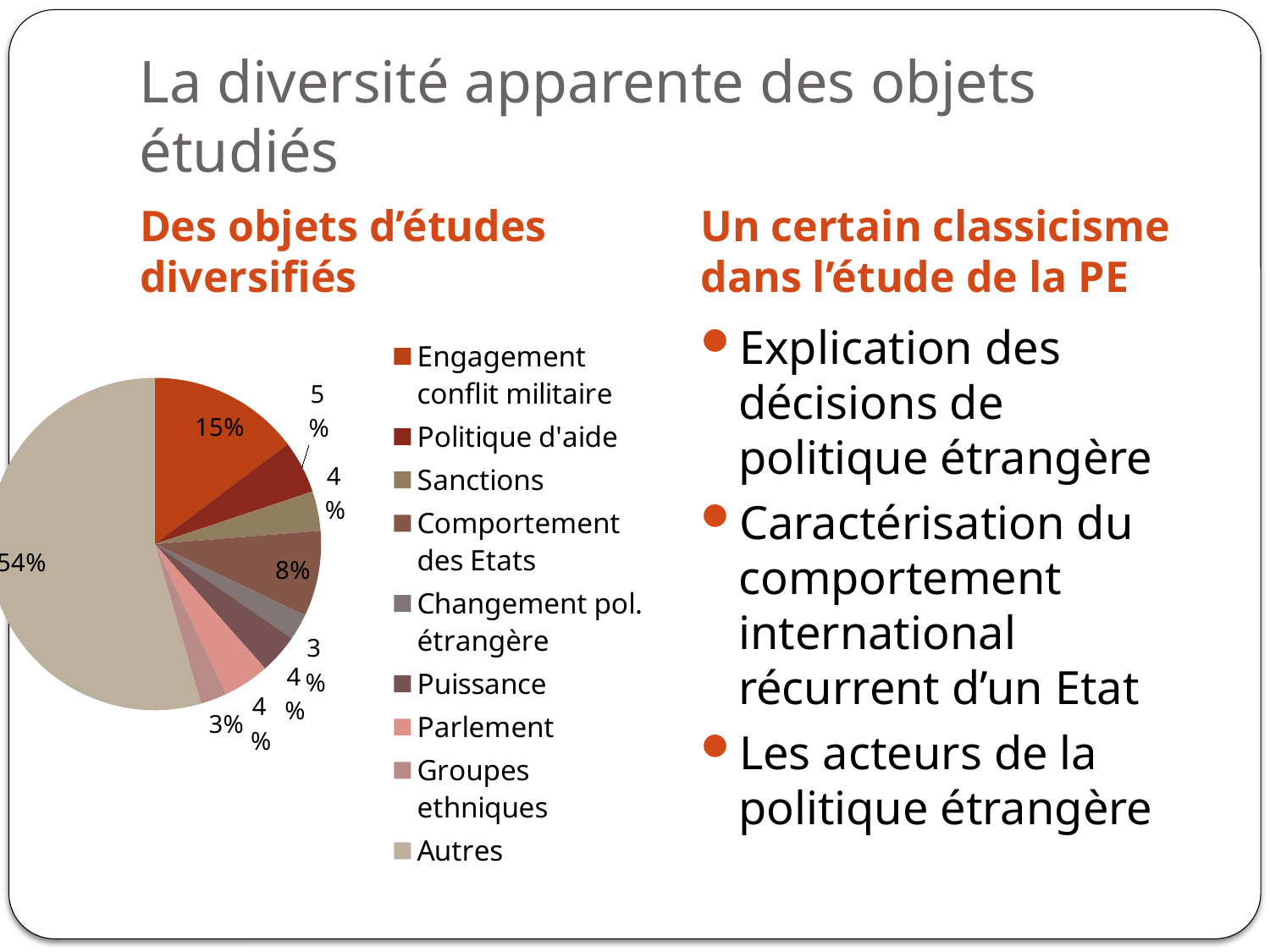
What share of the pie does "Engagement conflit militaire" represent? 15% What is the value shown for "Politique d'aide"? 5% What kind of chart is shown on the slide? Pie chart How many slices does the pie chart have? 9 What share of the pie does "Autres" represent? 54% Which category has the largest slice of the pie? Autres What is the value shown for "Sanctions"? 4% What is the difference in percentage points between "Engagement conflit militaire" and "Comportement des Etats"? 7 percentage points Which is larger, the slice for "Engagement conflit militaire" or the slice for "Comportement des Etats"? Engagement conflit militaire How many entries does the legend of the pie chart list? 9 What is the value shown for "Comportement des Etats"? 8% What is the heading above the pie chart on the left side of the slide? Des objets d'études diversifiés